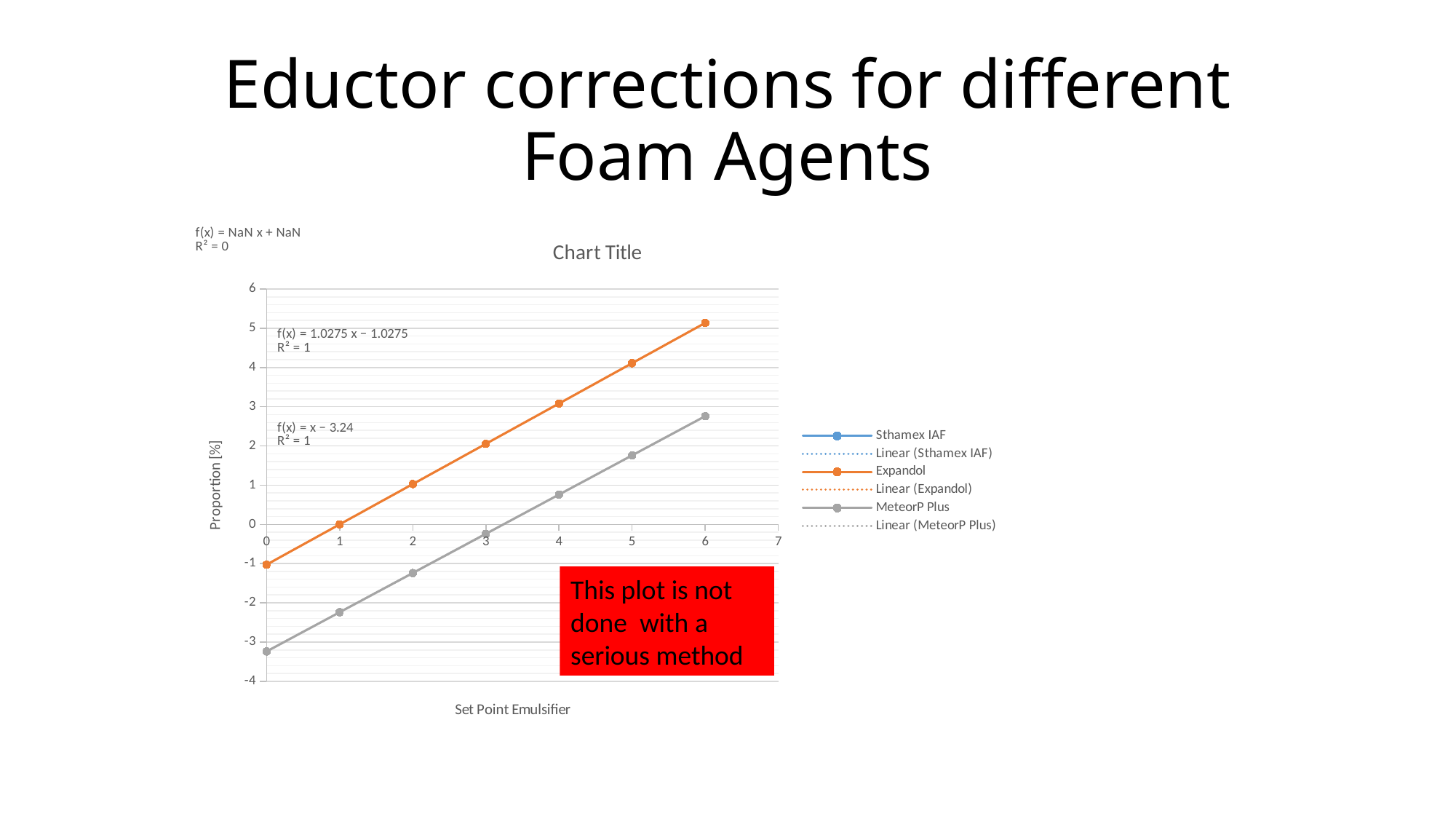
Do the MeteorP Plus values rise or fall along the x axis? rise Is the MeteorP Plus value at Set Point Emulsifier 6 greater or less than 3? less Do the Expandol values rise or fall as Set Point Emulsifier increases? rise Is the MeteorP Plus value at Set Point Emulsifier 0 greater or less than -3? less How many data points are plotted for the Expandol series? 7 At Set Point Emulsifier 3, which series has the larger value, Expandol or MeteorP Plus? Expandol What kind of chart is shown on the slide? line chart What is the trendline equation shown for Expandol? f(x) = 1.0275 x − 1.0275 What is the label on the y axis? Proportion [%] How many entries does the legend list? 6 Is the Expandol value at Set Point Emulsifier 6 greater or less than 4? greater What is the Expandol value at Set Point Emulsifier 1? 0